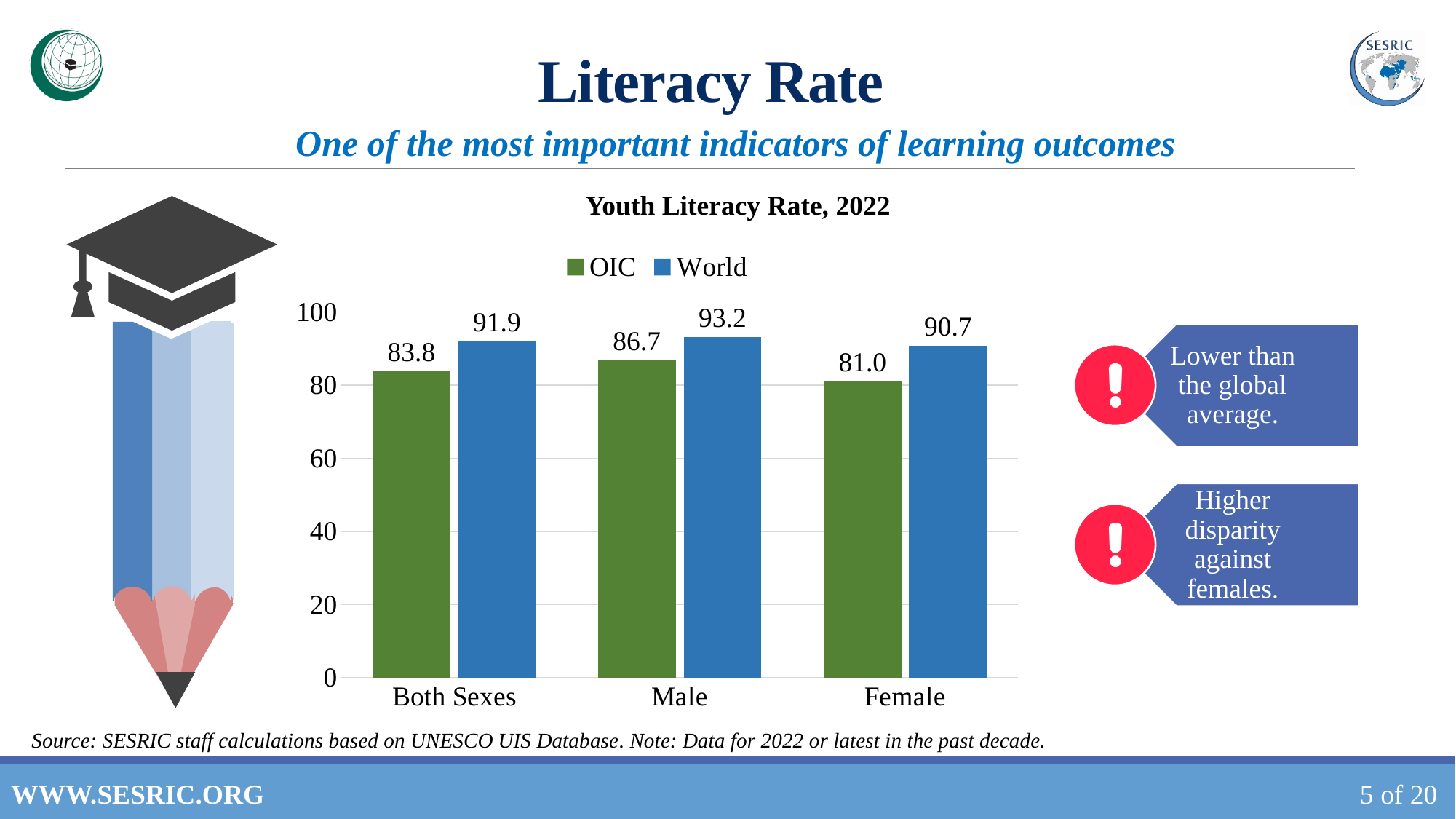
Which is larger, the OIC value for Male or the OIC value for Both Sexes? Male What is the difference between the OIC values for Male and Female? 5.7 Which category has the highest World value? Male What is the World youth literacy rate for Male? 93.2 Which category has the lowest OIC value? Female What is the OIC youth literacy rate for Both Sexes? 83.8 How many categories are shown on the x axis? 3 What is the OIC youth literacy rate for Female? 81.0 What is the difference between the World and OIC values for Female? 9.7 What type of chart is shown on the slide? Bar chart How many series does the legend list? 2 What is the World youth literacy rate for Female? 90.7